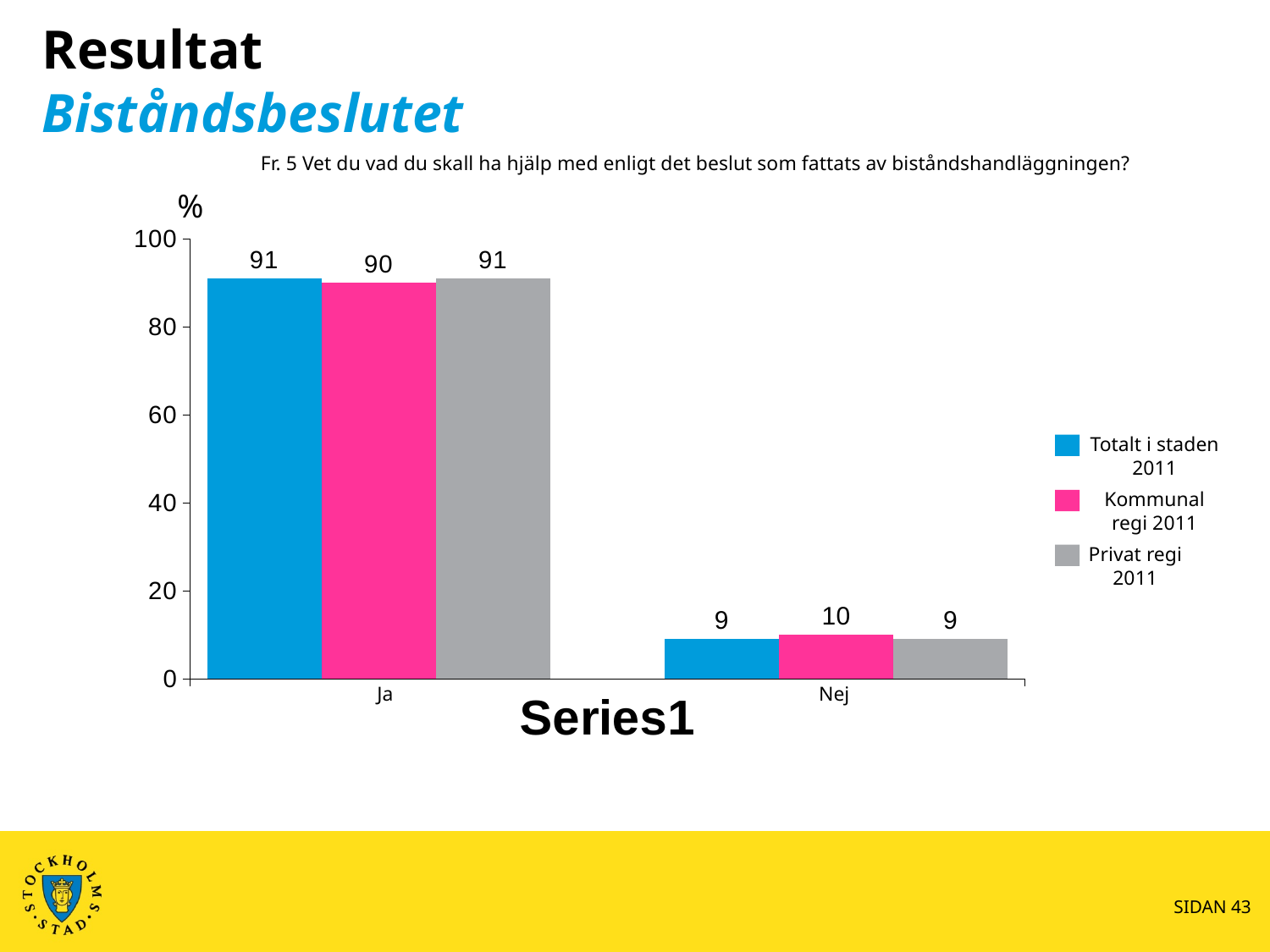
What is the value for Kommunal regi 2011 in the Ja category? 90 What is the value for Totalt i staden 2011 in the Ja category? 91 Which series has the highest value in the Nej category? Kommunal regi 2011 What is the value for Privat regi 2011 in the Ja category? 91 What unit is shown on the y axis of the chart? % How many series does the legend list? 3 What is the difference between the Ja and Nej values for Totalt i staden 2011? 82 How many categories are shown on the x axis? 2 Which is larger: the Ja value for Totalt i staden 2011 or the Ja value for Kommunal regi 2011? Totalt i staden 2011 What is the value for Kommunal regi 2011 in the Nej category? 10 What kind of chart is shown on the slide? Bar chart What is the difference between the Kommunal regi 2011 and Privat regi 2011 values in the Nej category? 1